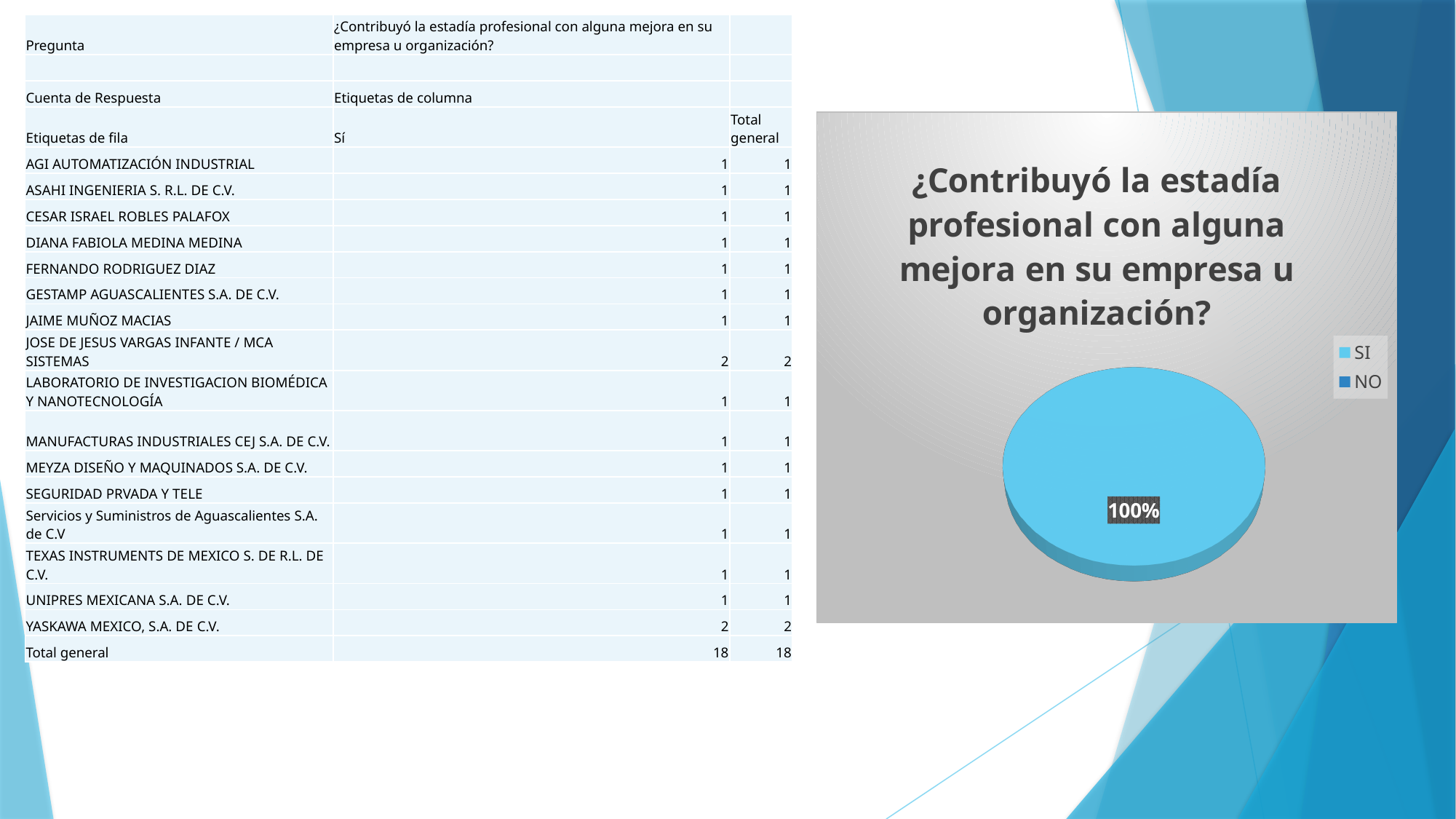
How many entries does the legend of the pie chart list? 2 What is the data label printed on the pie chart? 100% Which is larger in the pie chart, SI or NO? SI Which category has the largest slice in the pie chart? SI What is the title of the pie chart? ¿Contribuyó la estadía profesional con alguna mejora en su empresa u organización? What share of the pie chart does the SI slice represent? 100% Which category has the smallest share in the pie chart? NO What colour is the SI slice in the pie chart? light blue How many slices are visible in the pie chart? 1 What kind of chart is shown on the slide? pie chart